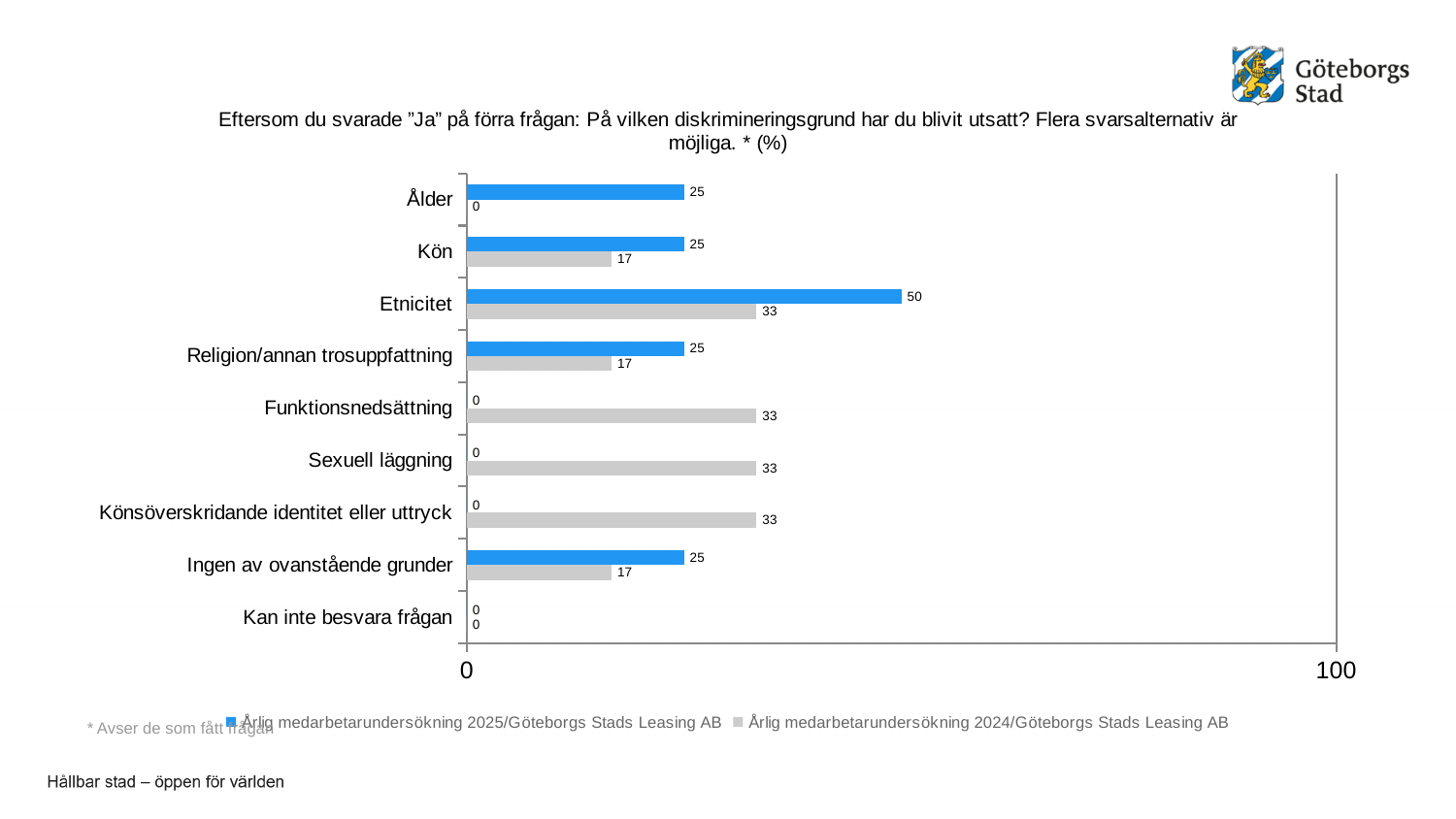
What kind of chart is shown on the slide? bar chart Which is larger for Sexuell läggning: the 2025 value or the 2024 value? the 2024 value Which category has the highest value in the 2025 series? Etnicitet What is the value for Ålder in the 2024 series? 0 How many series does the legend list? 2 What is the difference between the 2025 and 2024 values for Etnicitet? 17 What is the value for Kön in the 2024 series (Årlig medarbetarundersökning 2024)? 17 What is the value for Funktionsnedsättning in the 2025 series? 0 What is the difference between the 2025 and 2024 values for Religion/annan trosuppfattning? 8 Which colour represents the 2025 series (Årlig medarbetarundersökning 2025) in the chart? blue What is the value for Etnicitet in the 2025 series (Årlig medarbetarundersökning 2025)? 50 How many categories are shown on the chart? 9